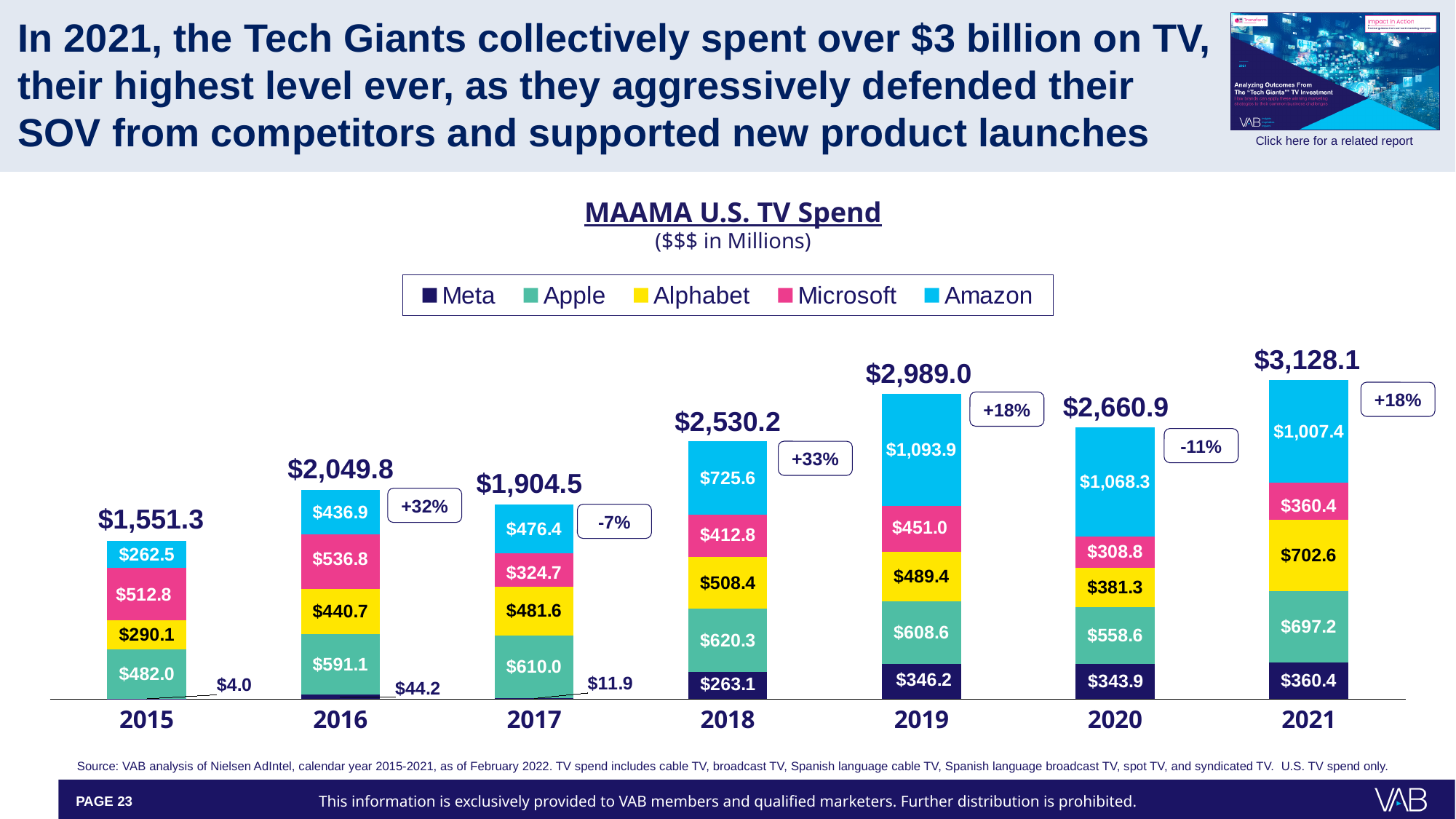
Which year has the highest total MAAMA U.S. TV spend? 2021 How many series does the legend list? 5 How many years are shown on the x axis? 7 Which year has the lowest total MAAMA U.S. TV spend? 2015 Which was larger in 2018, Apple's spend or Alphabet's spend? Apple What is the total MAAMA U.S. TV spend for 2021? $3,128.1 What was Amazon's U.S. TV spend in 2019? $1,093.9 What is the difference between Microsoft's spend in 2016 and in 2017? $212.1 What percentage change is shown next to the 2020 bar? -11% What was Meta's U.S. TV spend in 2015? $4.0 What type of chart is shown on the slide? Stacked bar chart What was Alphabet's U.S. TV spend in 2021? $702.6